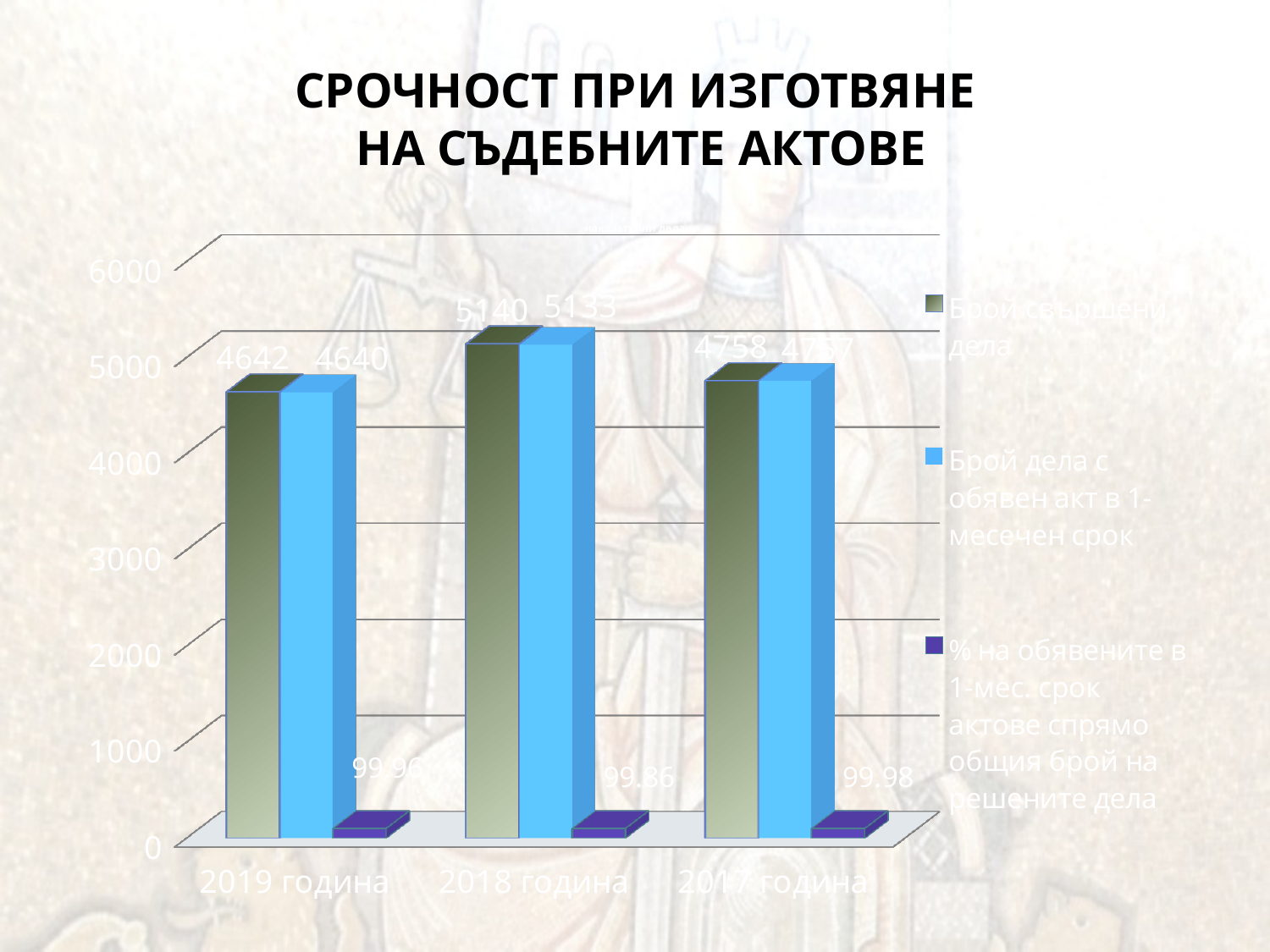
Which year has the highest value for "Брой свършени дела"? 2018 година Is the value of "Брой свършени дела" for 2018 година greater or less than 5000? greater Which year has the lowest value for "Брой дела с обявен акт в 1-месечен срок"? 2019 година What is the percentage value ("% на обявените в 1-мес. срок актове...") shown for 2017 година? 99.98 What is the value of "Брой свършени дела" for 2017 година? 4758 How many year categories are shown on the x axis? 3 Which is larger: "Брой свършени дела" for 2017 година or for 2019 година? 2017 година What kind of chart is shown on the slide? bar chart What is the difference between "Брой свършени дела" and "Брой дела с обявен акт в 1-месечен срок" for 2018 година? 7 How many series does the legend list? 3 What is the value of "Брой свършени дела" for 2019 година? 4642 What is the value of "Брой дела с обявен акт в 1-месечен срок" for 2018 година? 5133